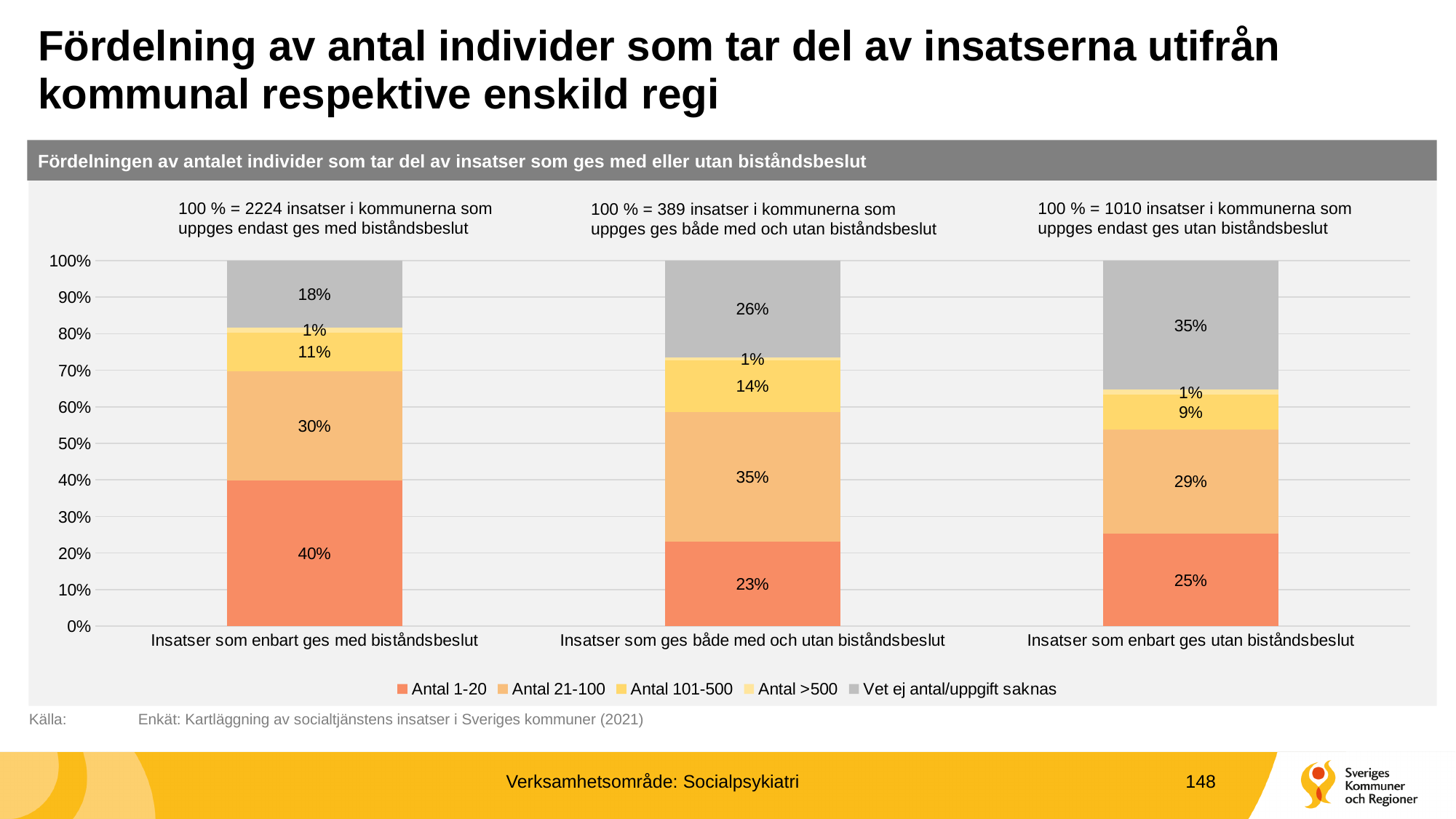
Which category has the lowest value for "Vet ej antal/uppgift saknas"? Insatser som enbart ges med biståndsbeslut What kind of chart is shown on the slide? Stacked bar chart What is the difference between the "Antal 21-100" values for "Insatser som ges både med och utan biståndsbeslut" and "Insatser som enbart ges med biståndsbeslut"? 5% What is the value for "Antal 21-100" in the "Insatser som enbart ges utan biståndsbeslut" bar? 29% Which is larger: the "Antal 1-20" value for "Insatser som ges både med och utan biståndsbeslut" or for "Insatser som enbart ges utan biståndsbeslut"? Insatser som enbart ges utan biståndsbeslut According to the note above the chart, how many insatser does 100% correspond to for "Insatser som ges både med och utan biståndsbeslut"? 389 How many categories are shown on the x axis? 3 What is the value for "Antal 101-500" in the "Insatser som ges både med och utan biståndsbeslut" bar? 14% How many series does the legend list? 5 What is the value for "Antal 1-20" in the "Insatser som enbart ges med biståndsbeslut" bar? 40% What is the value for "Vet ej antal/uppgift saknas" in the "Insatser som enbart ges utan biståndsbeslut" bar? 35% Which category has the highest value for "Antal 1-20"? Insatser som enbart ges med biståndsbeslut